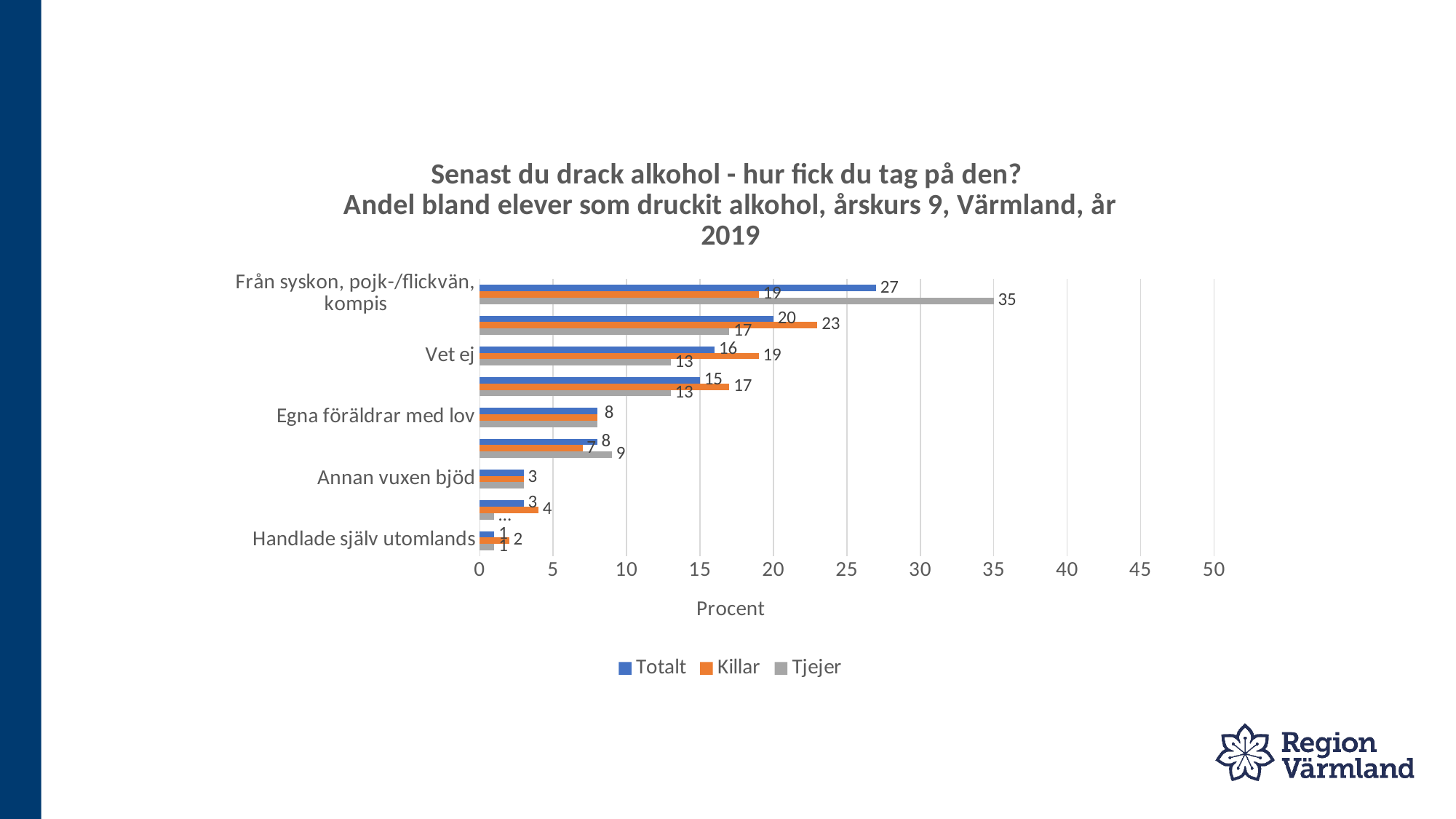
Which category has the highest Tjejer value? Från syskon, pojk-/flickvän, kompis What is the label of the horizontal axis? Procent What type of chart is shown on the slide? bar chart For 'Vet ej', which is larger: the Killar value or the Tjejer value? Killar What is the difference between the Tjejer and Totalt values for 'Från syskon, pojk-/flickvän, kompis'? 8 What is the Totalt value for 'Från syskon, pojk-/flickvän, kompis'? 27 What is the Tjejer value for 'Från syskon, pojk-/flickvän, kompis'? 35 What is the Tjejer value for 'Vet ej'? 13 What is the Totalt value for 'Egna föräldrar med lov'? 8 What is the Killar value for 'Handlade själv utomlands'? 2 What is the Killar value for 'Vet ej'? 19 How many series does the legend list? 3